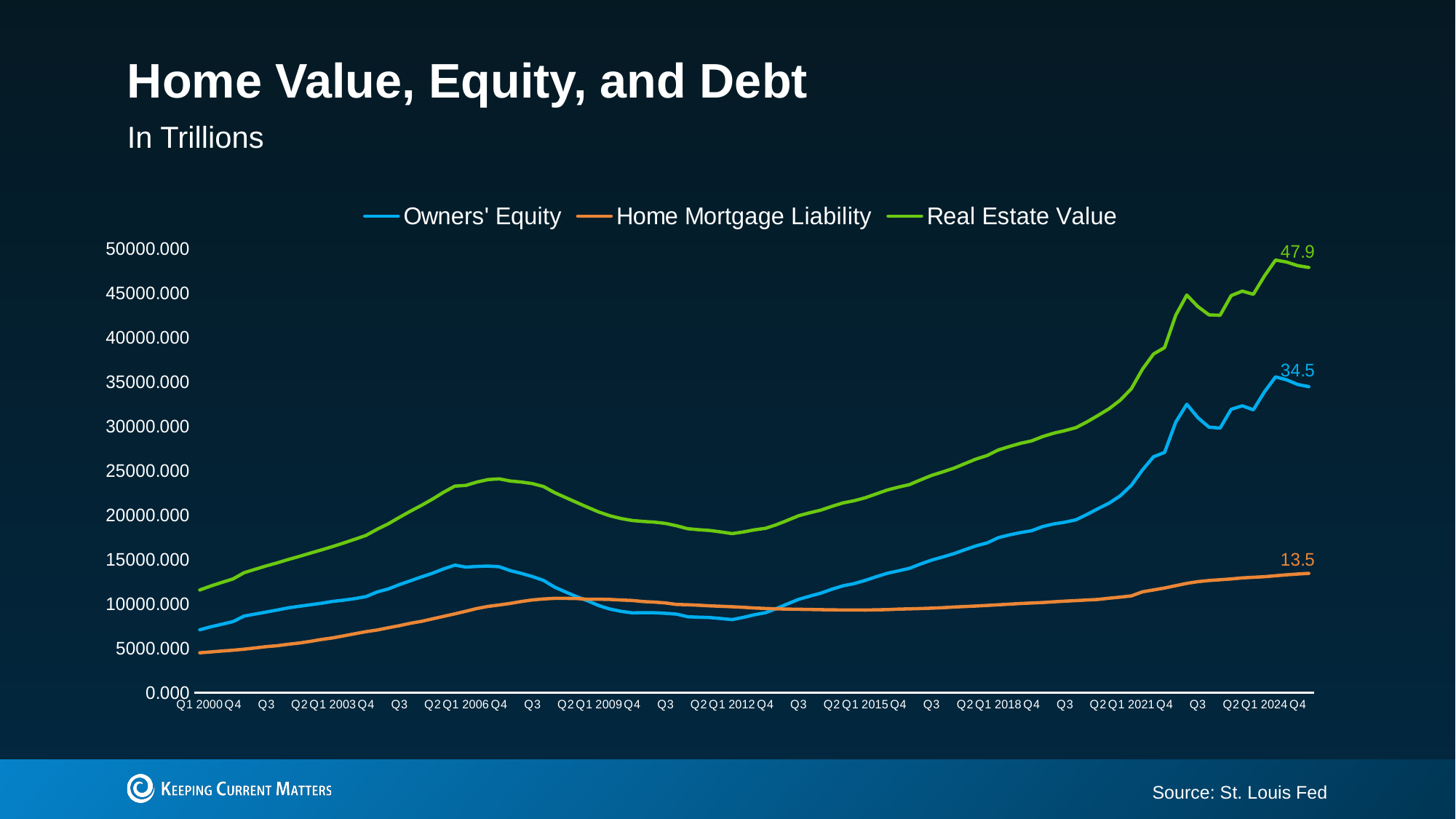
Is the value for Real Estate Value at Q1 2000 greater or less than 15000.000? less Which series has the lowest value at the end of the chart? Home Mortgage Liability What is the difference between the labelled final values for Owners' Equity and Home Mortgage Liability? 21.0 At the end of the chart, which is larger: Owners' Equity or Home Mortgage Liability? Owners' Equity What kind of chart is shown on the slide? Line chart What is the labelled final value for Home Mortgage Liability? 13.5 What is the difference between the labelled final values for Real Estate Value and Owners' Equity? 13.4 How many series does the legend list? 3 What is the labelled final value for Real Estate Value? 47.9 Which series has the highest value at the end of the chart? Real Estate Value What is the labelled final value for Owners' Equity? 34.5 Is the value for Home Mortgage Liability at Q1 2000 greater or less than 10000.000? less